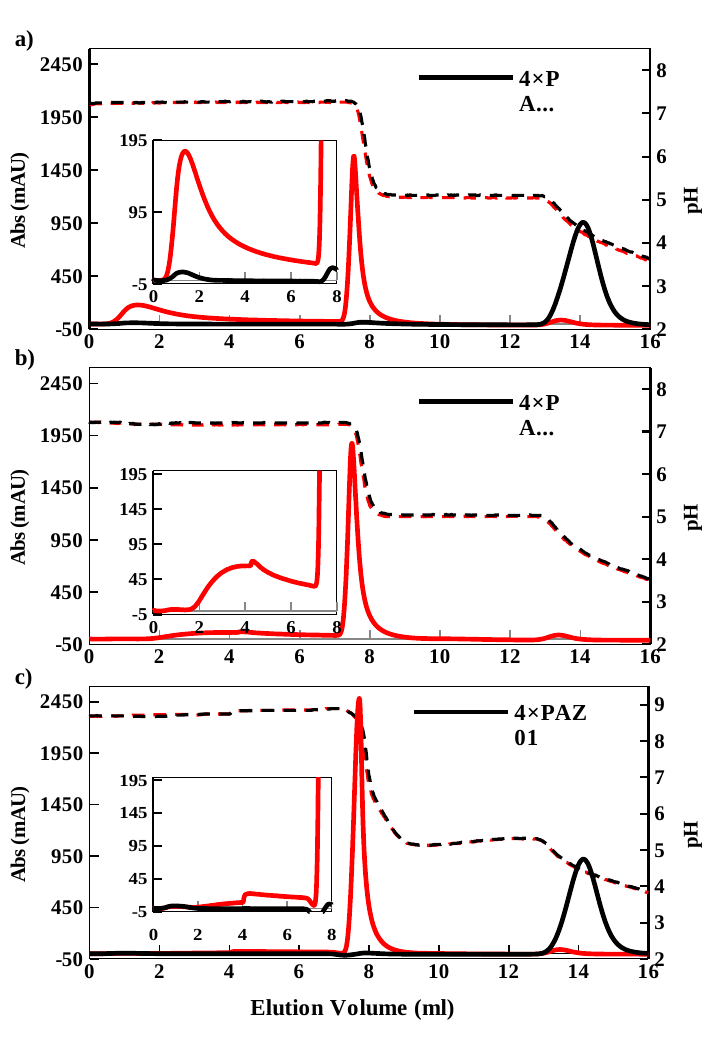
In panel c), is the pH value at 0 ml greater or less than 8? greater How many chart panels are shown on the slide? 3 In panel a), is the peak value of the black absorbance curve near 14 ml greater or less than 1450 mAU? less What is the x-axis label shared by the charts? Elution Volume (ml) In panel c), is the peak value of the red absorbance curve near 8 ml greater or less than 1950 mAU? greater In panel a), does the dashed pH curve rise or fall as elution volume increases from 0 to 16 ml? fall What kind of chart is shown in panel a)? line chart In panel c), which peak is higher: the red peak near 8 ml or the black peak near 14 ml? the red peak near 8 ml What is the label of the right-hand y-axis in panel c)? pH